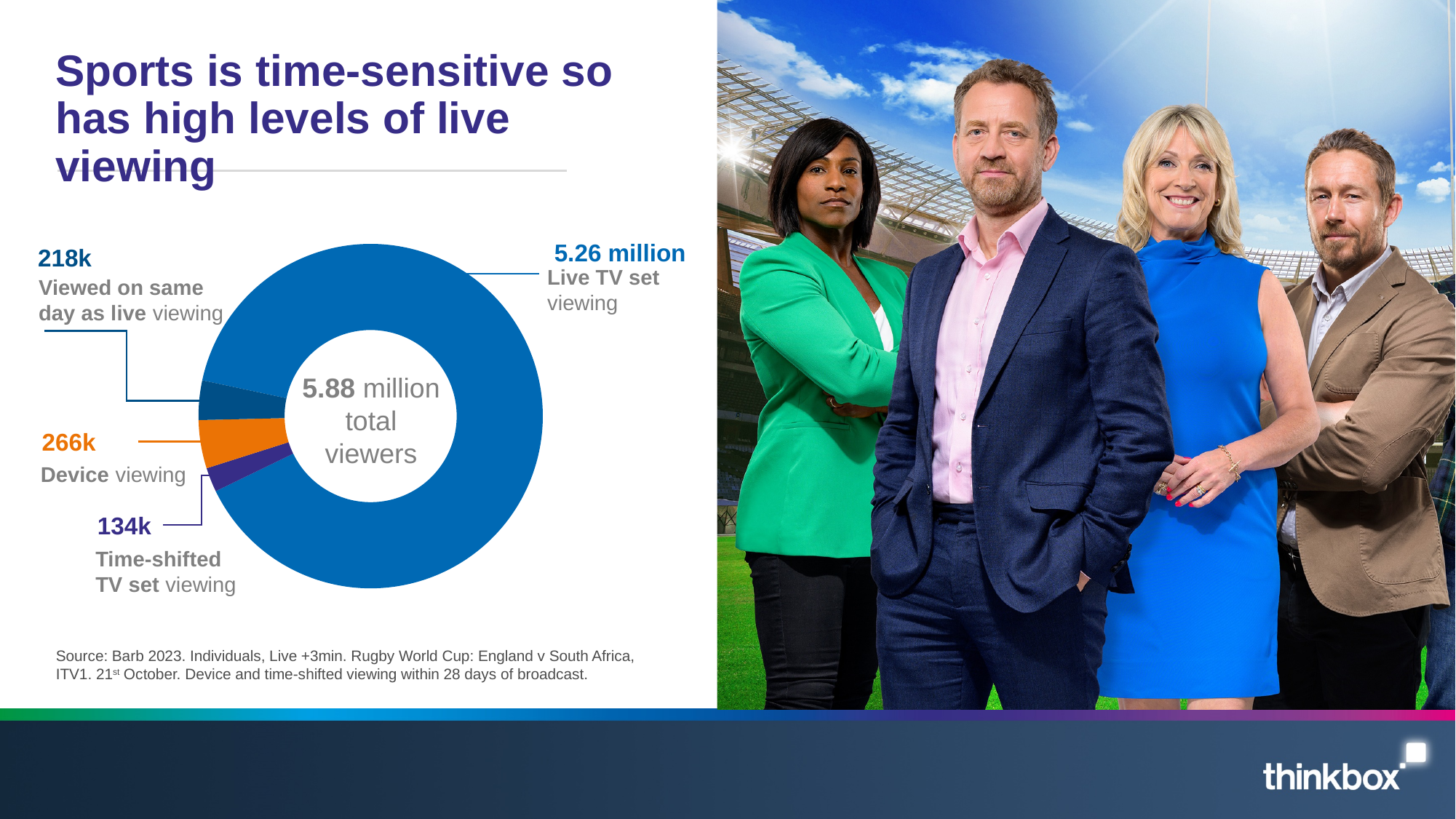
How many segments does the chart have? 4 Which is larger, Device viewing or Time-shifted TV set viewing? Device viewing What total number of viewers is shown in the centre of the chart? 5.88 million What is the value for Live TV set viewing? 5.26 million What is the difference between Device viewing and Viewed on same day as live viewing? 48k Which category has the largest share of the chart? Live TV set viewing What is the difference between Viewed on same day as live viewing and Time-shifted TV set viewing? 84k What is the value for Time-shifted TV set viewing? 134k What kind of chart is shown on the slide? Donut (pie) chart What is the value for Device viewing? 266k Which category has the smallest value? Time-shifted TV set viewing What is the value for Viewed on same day as live viewing? 218k